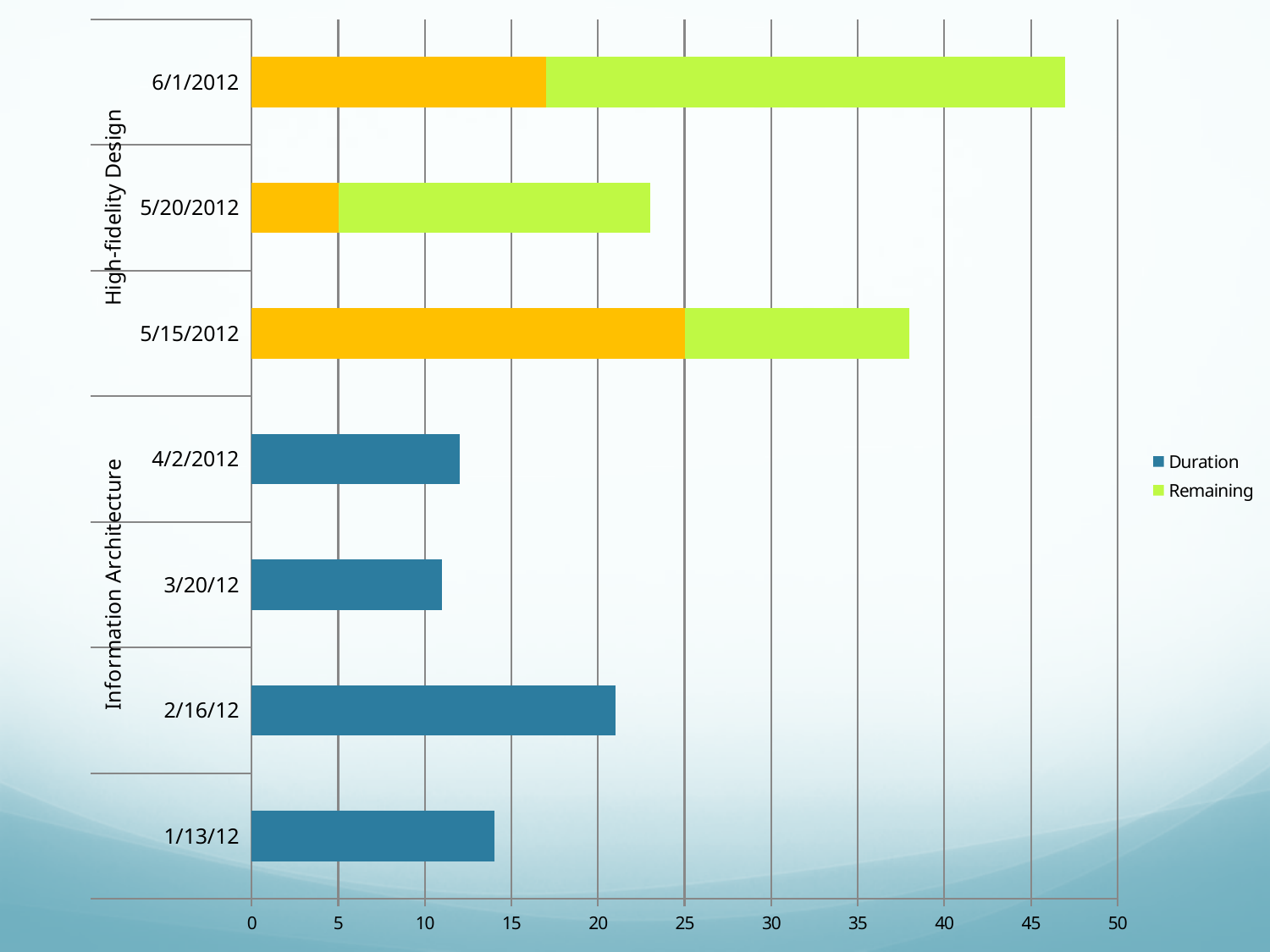
Which two groups are the date categories divided into on the vertical axis? High-fidelity Design and Information Architecture What kind of chart is shown on the slide? bar chart Is the Duration value for 1/13/12 greater or less than 15? less How many series does the legend list? 2 What is the Duration value for 5/20/2012? 5 Which date has the smallest Duration segment? 5/20/2012 Is the total bar length for 6/1/2012 greater or less than 45? greater Which date has the longest total bar? 6/1/2012 How many date categories are plotted on the chart? 7 Which has the larger Duration value, 2/16/12 or 3/20/12? 2/16/12 Is the Duration value for 2/16/12 greater or less than 20? greater What is the Duration value for 5/15/2012? 25